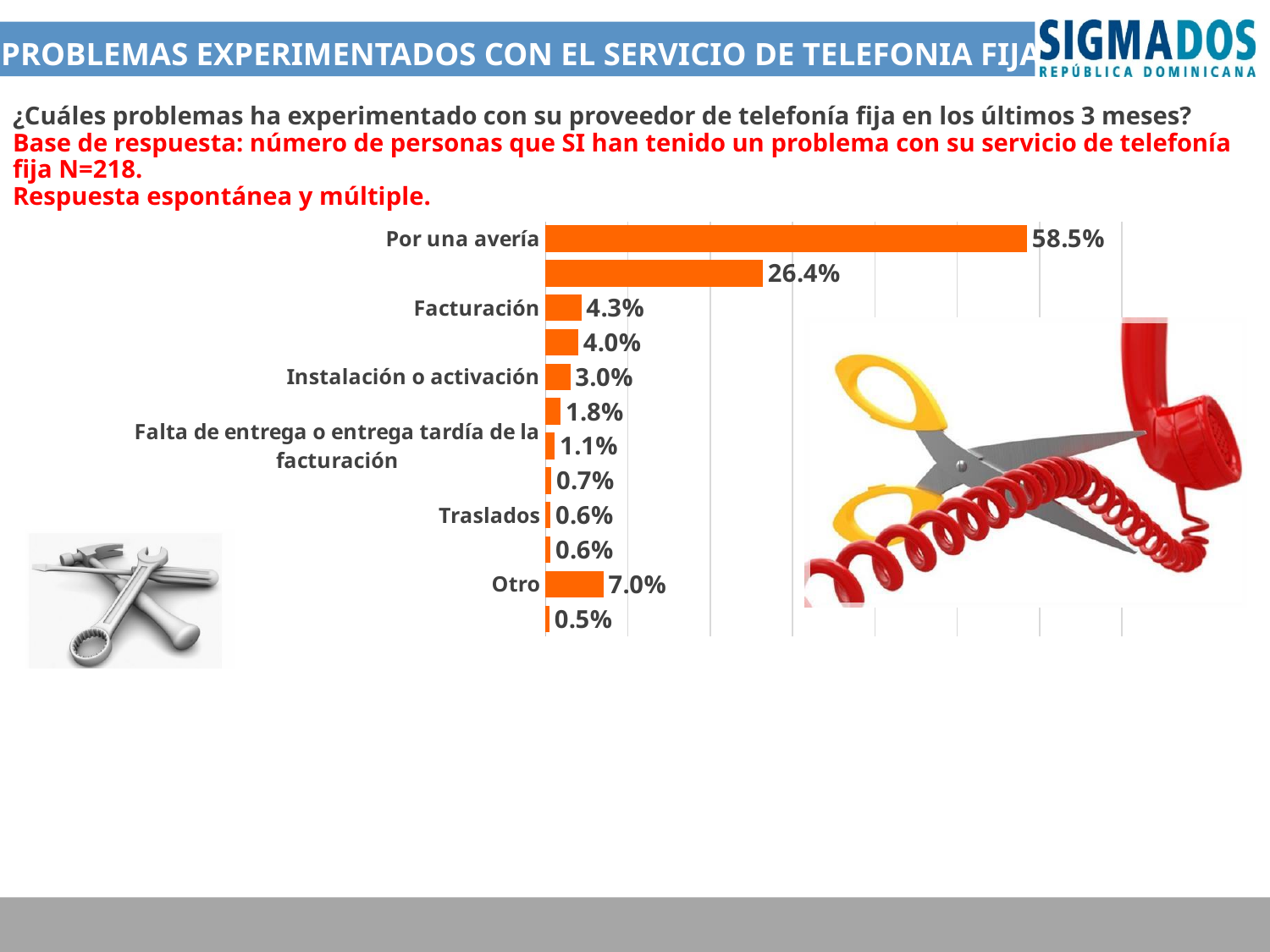
What is the value for "Otro"? 7.0% What is the smallest value shown on the chart? 0.5% What is the difference between the values for "Por una avería" and "Facturación"? 54.2% What is the value for "Facturación"? 4.3% What is the value for "Falta de entrega o entrega tardía de la facturación"? 1.1% What percentage is shown for "Por una avería"? 58.5% How many bars are plotted on the chart? 12 What percentage is shown for "Traslados"? 0.6% What type of chart is shown on the slide? Bar chart Which labelled category has the highest value? Por una avería Which is larger, the value for "Otro" or the value for "Facturación"? Otro What percentage is shown for "Instalación o activación"? 3.0%